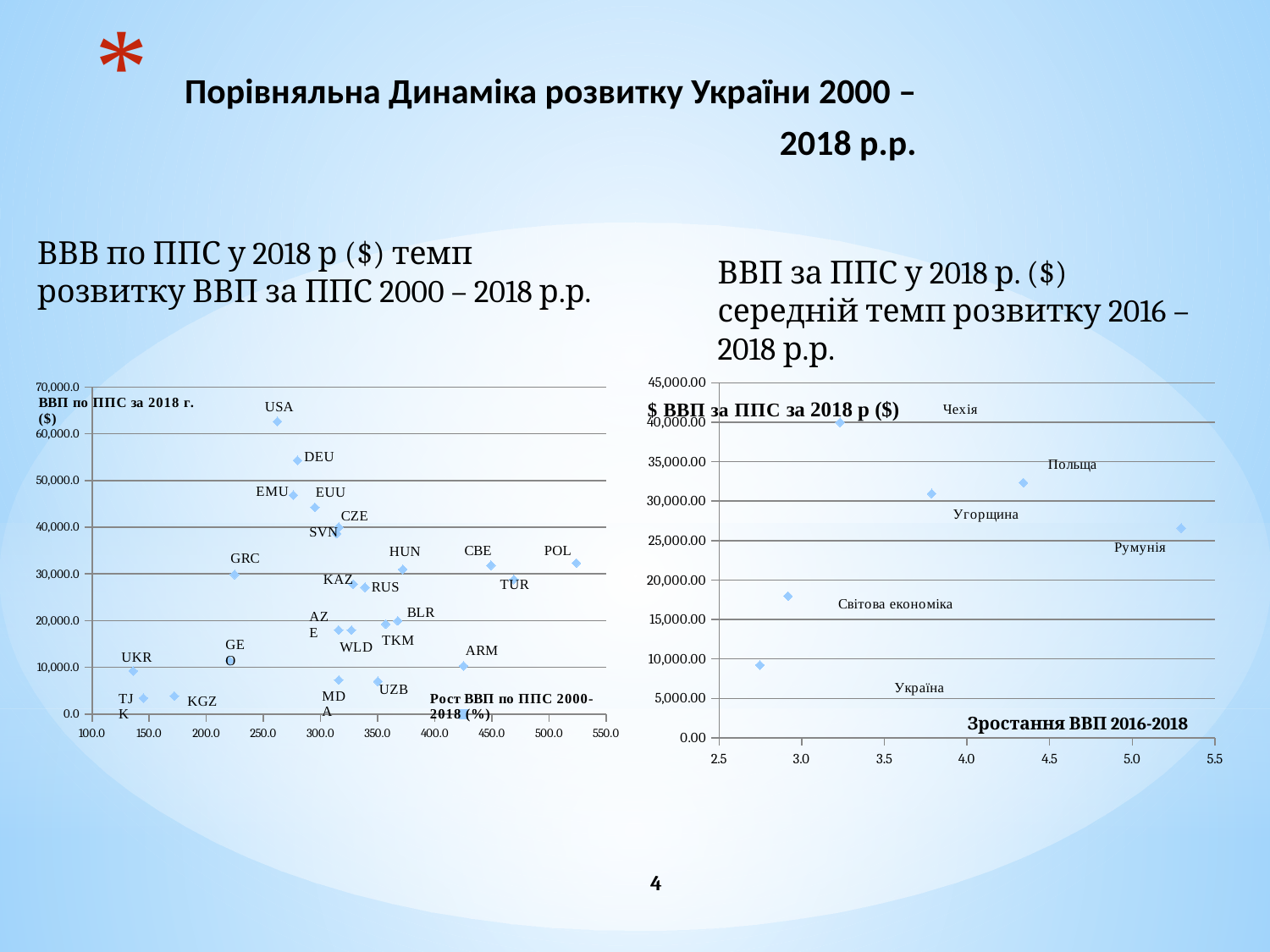
What is the x-axis title of the right chart? Зростання ВВП 2016-2018 In the left chart, which country has the highest ВВП по ППС за 2018 г. value? USA How many data points are plotted in the right chart? 6 In the right chart, which point has the lowest value? Україна In the left chart, is the value for DEU greater or less than 50,000.0? greater In the right chart, which has a higher value, Чехія or Польща? Чехія In the left chart, which has a higher ВВП по ППС за 2018 г. value, GRC or UKR? GRC In the right chart, is the value for Україна greater or less than 10,000.00? less In the left chart, is the value for UKR greater or less than 10,000.0? less What kind of chart is the left chart (ВВВ по ППС у 2018 р ($) темп розвитку ВВП за ППС 2000 – 2018 р.р.)? Scatter chart In the right chart (ВВП за ППС у 2018 р. ($) середній темп розвитку 2016 – 2018 р.р.), which point has the highest value? Чехія